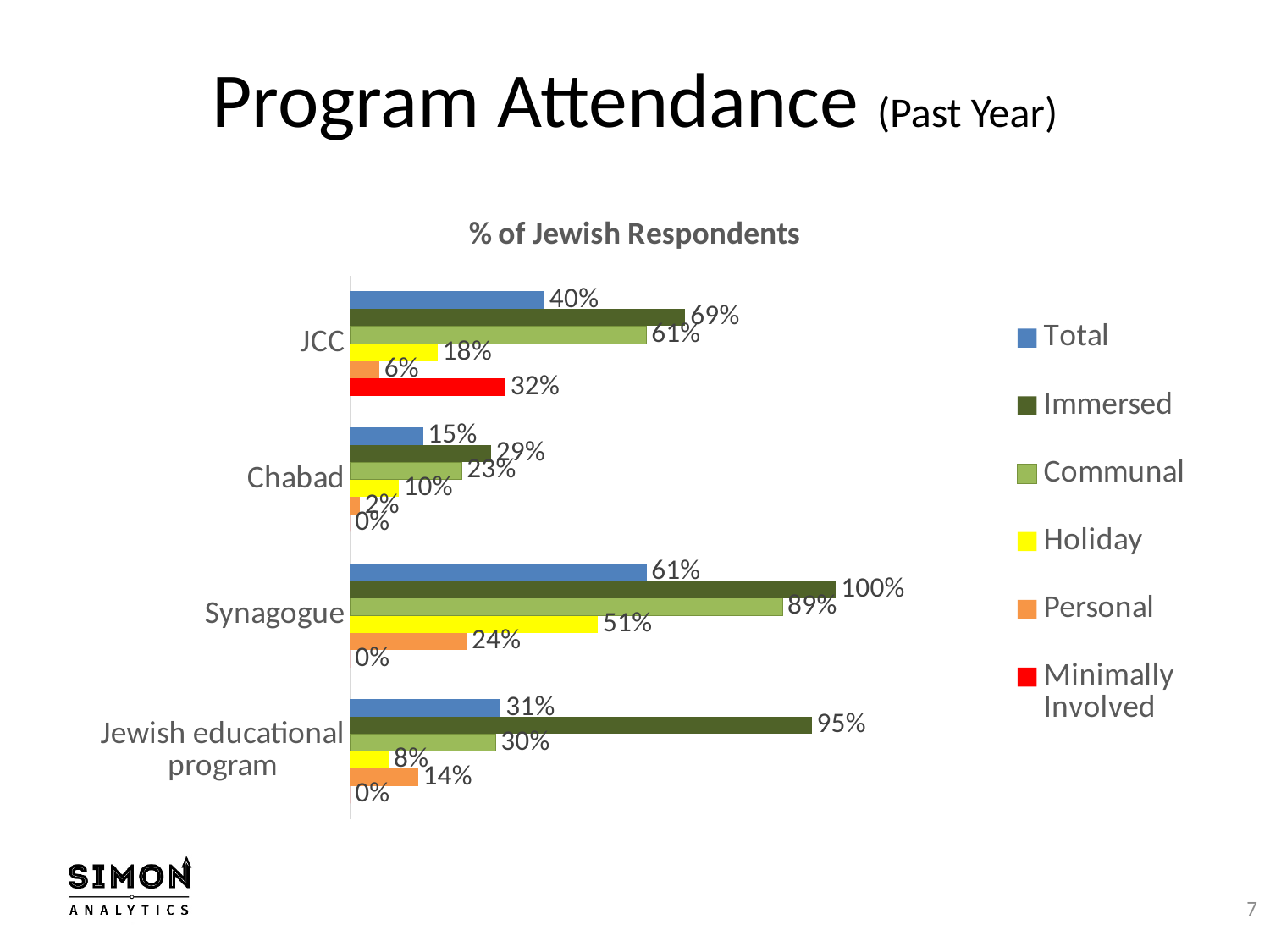
Which is larger for JCC, the Holiday value or the Minimally Involved value? Minimally Involved What is the Total value for Synagogue? 61% What is the Immersed value for Jewish educational program? 95% What is the Personal value for Chabad? 2% What kind of chart is shown on the slide? Bar chart How many series does the legend list? 6 What is the Minimally Involved value for JCC? 32% What is the title of the chart? % of Jewish Respondents Which program has the lowest Immersed value? Chabad How many program categories are shown on the chart? 4 What is the difference between the Immersed and Communal values for Synagogue? 11% Which program has the highest Total value? Synagogue